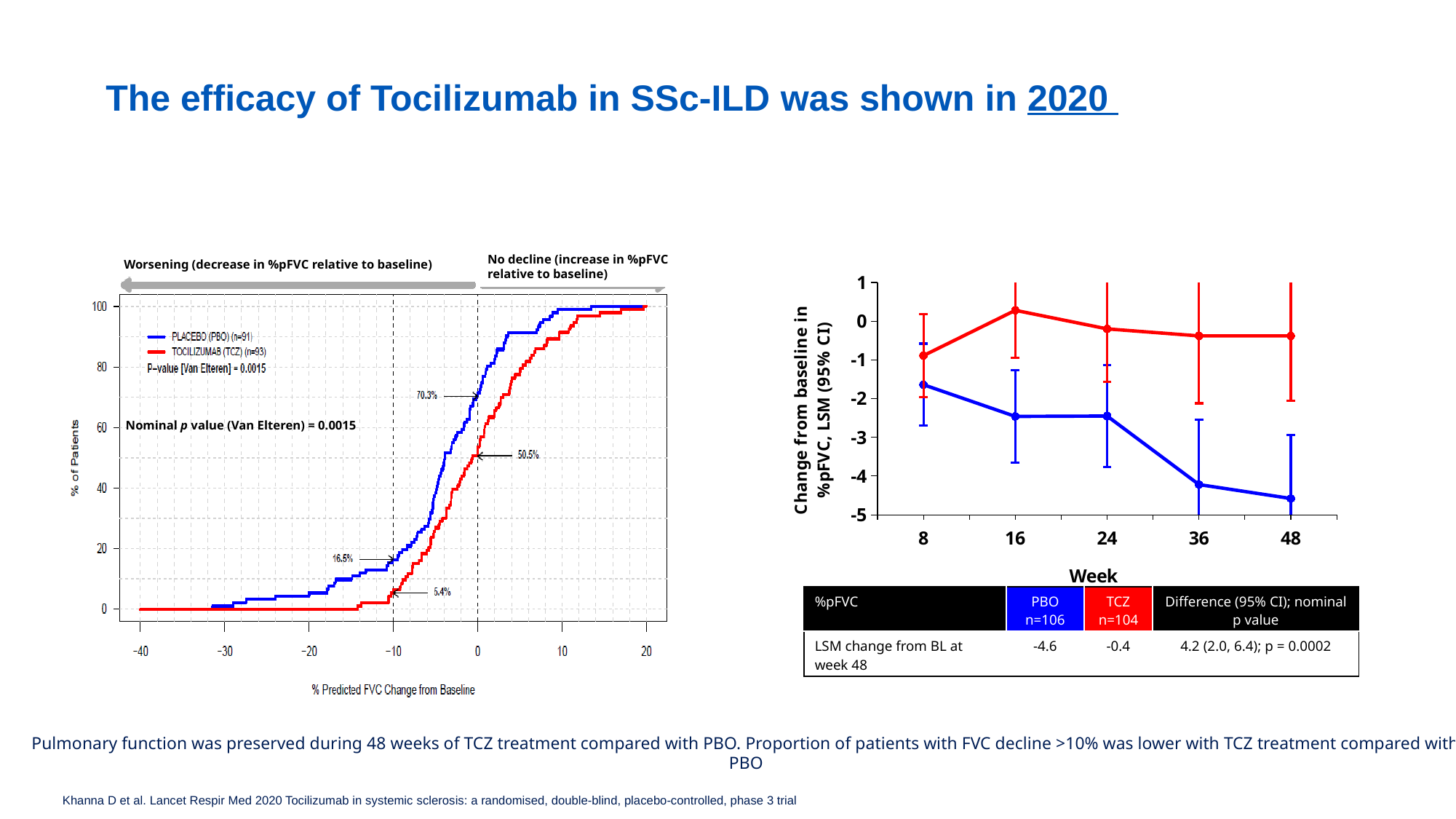
On the left chart, what percentage of tocilizumab patients is marked at the 0% predicted FVC change line? 50.5% On the left chart, what percentage of placebo patients is marked at the -10% predicted FVC change line? 16.5% On the left chart, what is the difference between the placebo and tocilizumab percentages marked at the -10% line? 11.1 percentage points On the right chart, what is the LSM change from baseline in %pFVC at week 48 for TCZ? -0.4 On the right chart, how many week time points are plotted on the x axis? 5 On the left chart, what is the nominal p value (Van Elteren) shown? 0.0015 On the right chart, what is the LSM change from baseline in %pFVC at week 48 for PBO? -4.6 On the left chart, what percentage of tocilizumab patients is marked at the -10% predicted FVC change line? 5.4% On the right chart, does the blue PBO line rise or fall from week 8 to week 48? fall On the left chart, how many series does the legend list? 2 On the right chart, is the PBO value at week 16 greater or less than -2? less On the left chart, what percentage of placebo patients is marked at the 0% predicted FVC change line? 70.3%